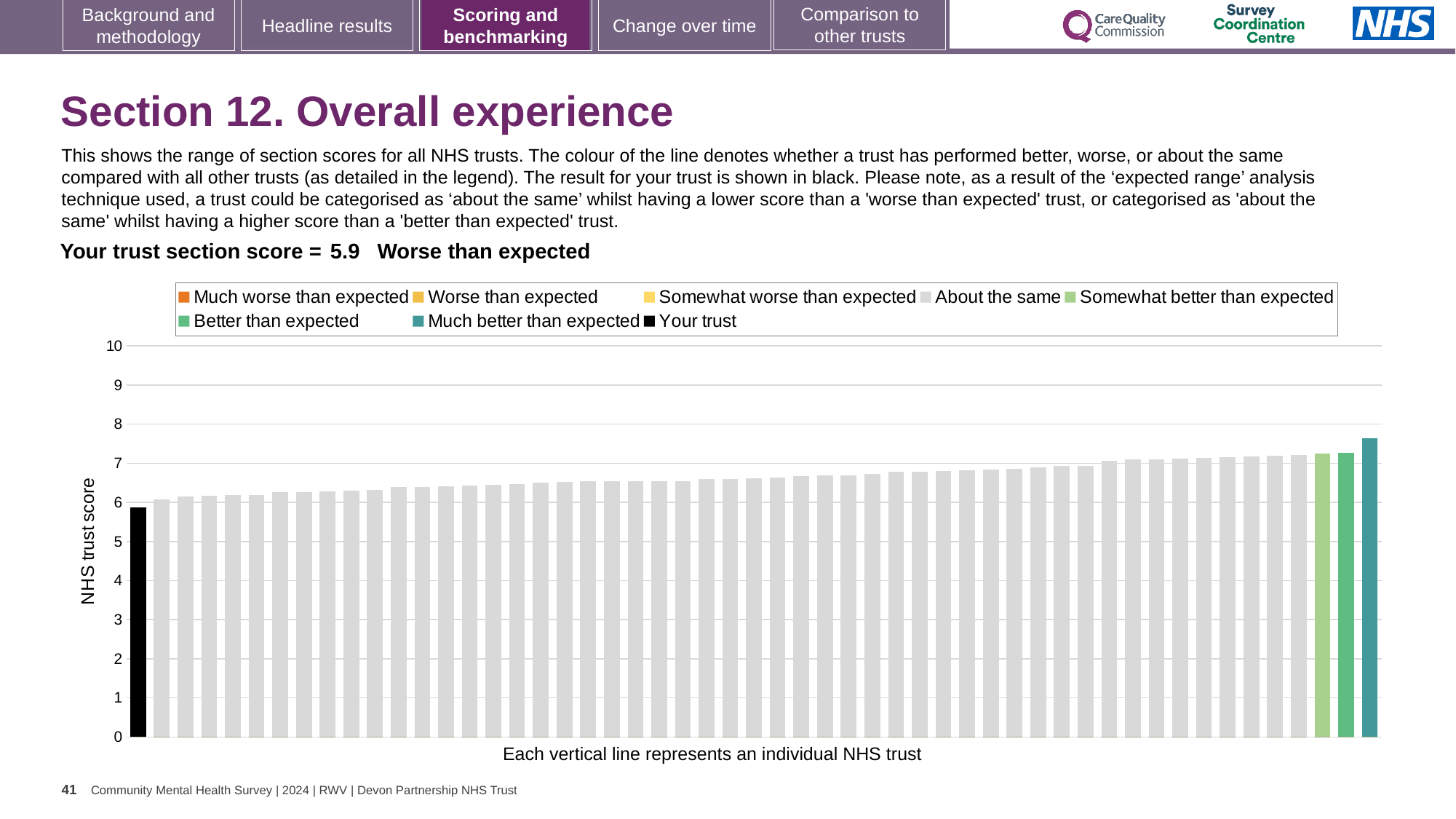
How is your trust's section score categorised compared with other trusts? Worse than expected What kind of chart is shown on the slide? Bar chart Which bar in the chart is the lowest? The black 'Your trust' bar Is the value of the tallest bar in the chart greater or less than 8? less Which legend category does the tallest bar in the chart belong to? Much better than expected What is the section score for your trust shown on the slide? 5.9 Is the value of the black 'Your trust' bar greater or less than 6? less Is the value of the tallest bar in the chart greater or less than 7? greater Do the bar values rise or fall from left to right along the x axis? Rise Which is larger: the value of the black 'Your trust' bar or the value of the rightmost bar? The rightmost bar How many entries does the chart legend list? 8 What is the label on the vertical axis of the chart? NHS trust score